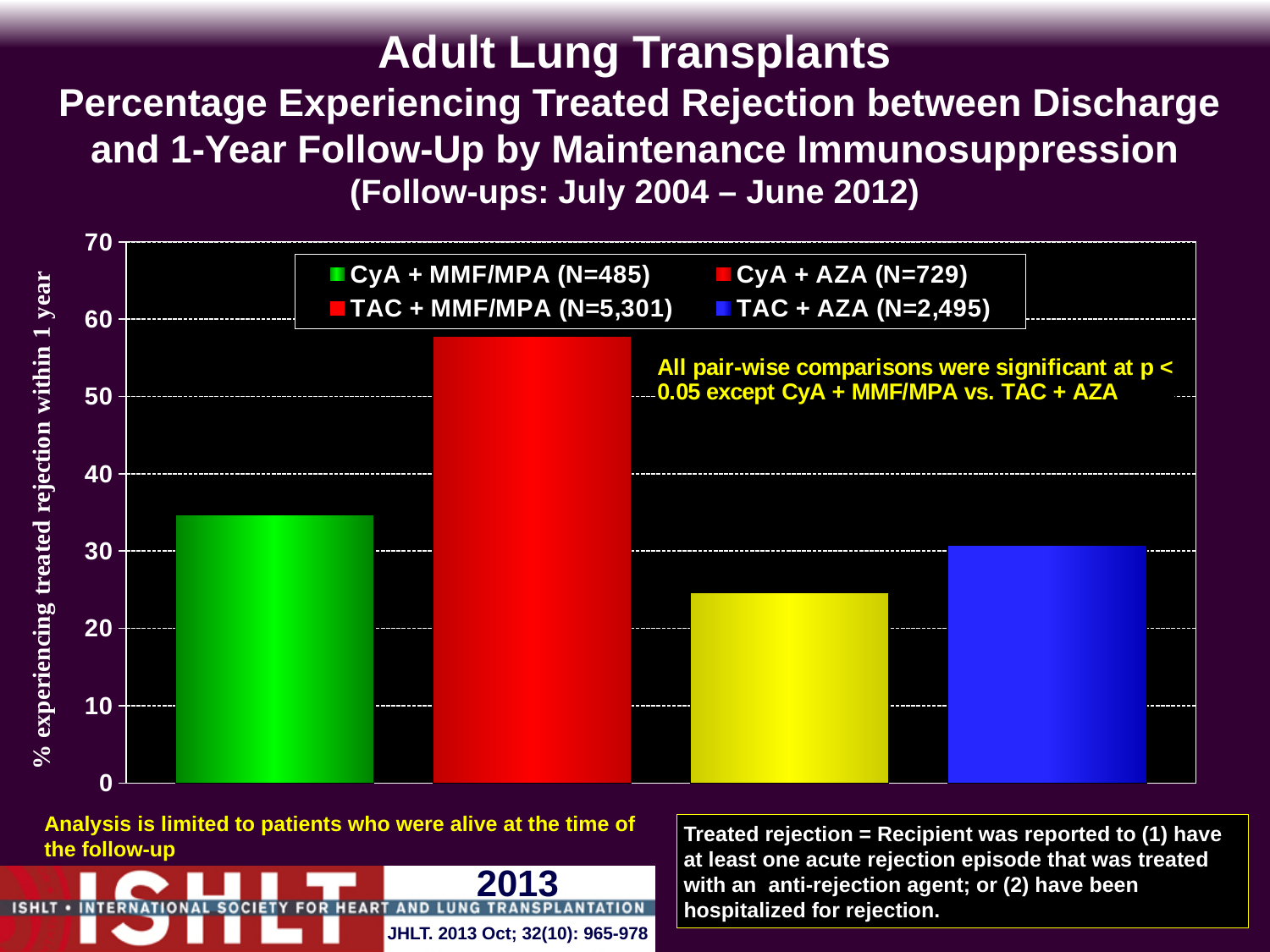
Is the value for CyA + AZA greater or less than 60? less What kind of chart is shown on the slide? bar chart Which is larger, the value for CyA + MMF/MPA or the value for TAC + AZA? CyA + MMF/MPA How many bars are plotted in the chart? 4 Which maintenance immunosuppression group has the lowest percentage experiencing treated rejection within 1 year? TAC + MMF/MPA Is the value for TAC + MMF/MPA greater or less than 20? greater Which maintenance immunosuppression group has the highest percentage experiencing treated rejection within 1 year? CyA + AZA Is the value for CyA + AZA greater or less than 50? greater How many entries does the legend list? 4 According to the legend, what is the N for the TAC + MMF/MPA group? 5,301